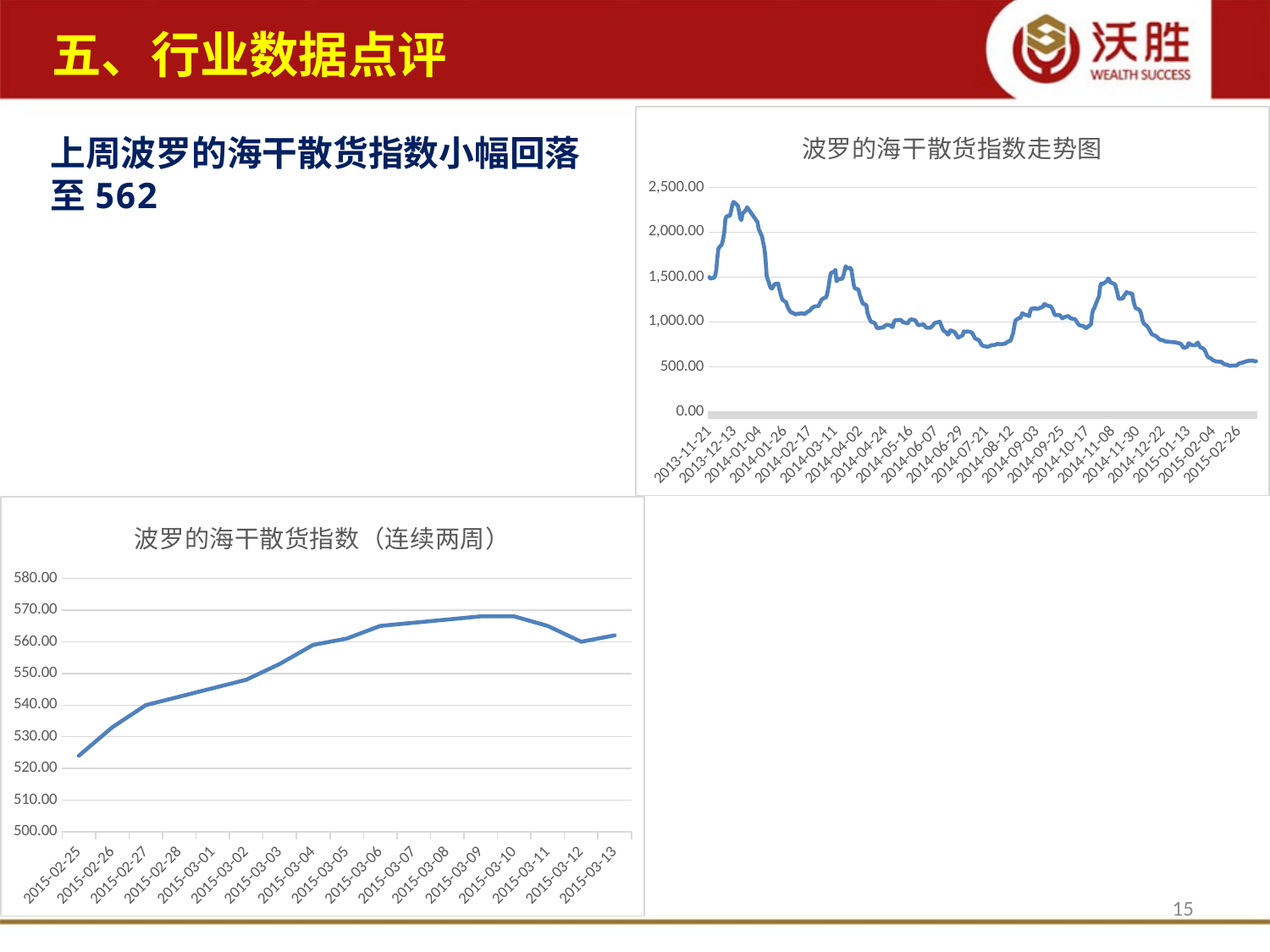
In the chart titled 波罗的海干散货指数（连续两周）, is the value for 2015-02-25 greater or less than 530? less In the chart titled 波罗的海干散货指数走势图, does the index overall rise or fall from 2013-12-13 to 2015-02-26? fall What kind of chart is the chart titled 波罗的海干散货指数（连续两周）? line chart What kind of chart is the chart titled 波罗的海干散货指数走势图? line chart In the chart titled 波罗的海干散货指数（连续两周）, how many dates are labelled on the x axis? 17 In the chart titled 波罗的海干散货指数（连续两周）, is the value for 2015-03-13 greater or less than 570? less In the chart titled 波罗的海干散货指数（连续两周）, is the value for 2015-03-10 greater or less than 560? greater How many charts are shown on the slide? 2 In the chart titled 波罗的海干散货指数（连续两周）, which is larger, the value for 2015-02-25 or the value for 2015-03-13? 2015-03-13 In the chart titled 波罗的海干散货指数（连续两周）, which date has the lowest value? 2015-02-25